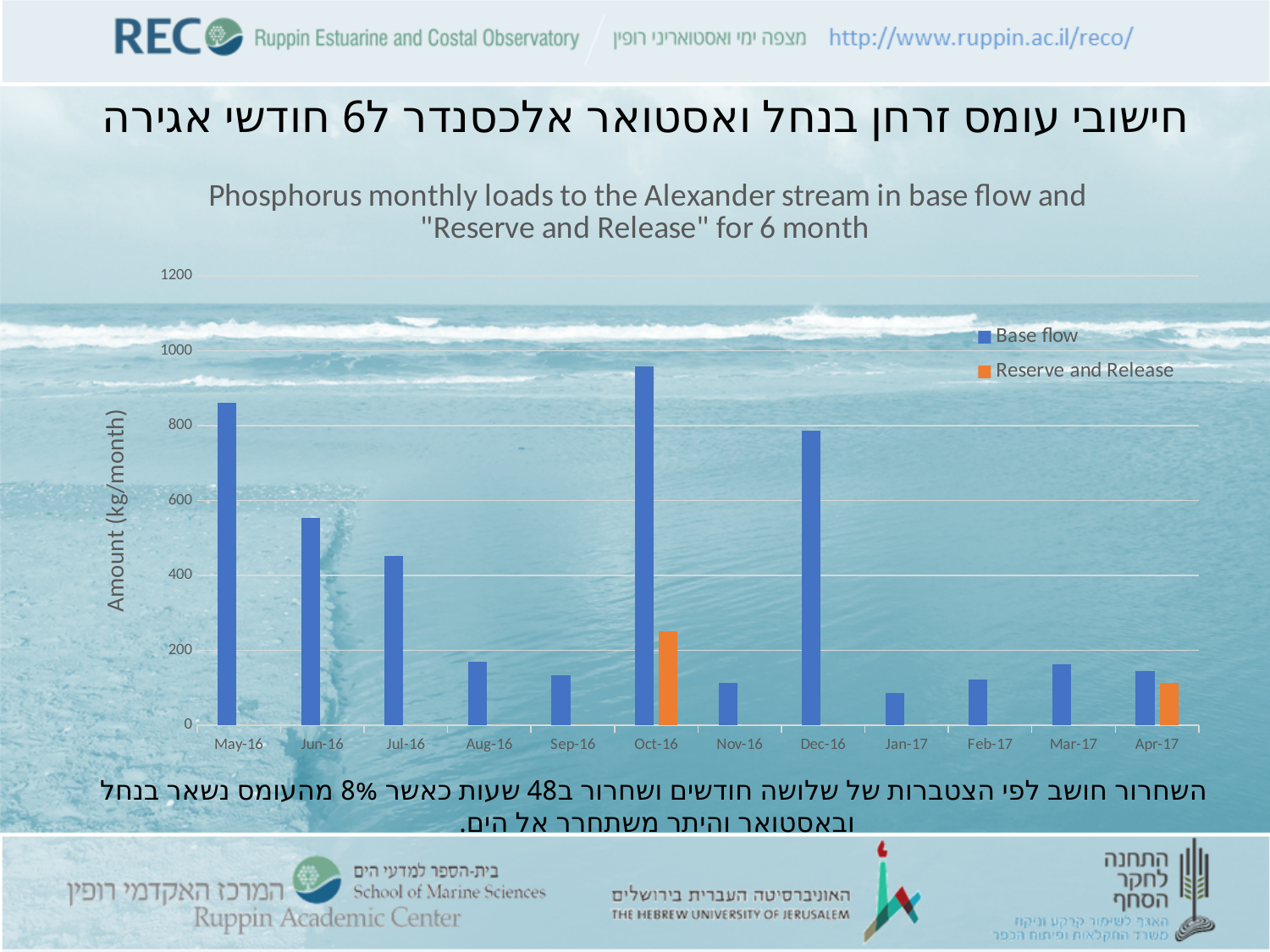
Is the Base flow value for May-16 greater or less than 800? greater What is the label of the y axis? Amount (kg/month) Is the Reserve and Release value for Oct-16 greater or less than 200? greater In which months does the Reserve and Release series have a bar? Oct-16 and Apr-17 Which month has the highest Base flow value? Oct-16 Which month has the lowest Base flow value? Jan-17 How many series does the legend list? 2 Do the Base flow values rise or fall from May-16 to Sep-16? fall Is the Base flow value for Jul-16 greater or less than 600? less Which is larger, the Base flow value for Jun-16 or for Dec-16? Dec-16 What kind of chart is shown on the slide? bar chart How many months are shown on the x axis? 12